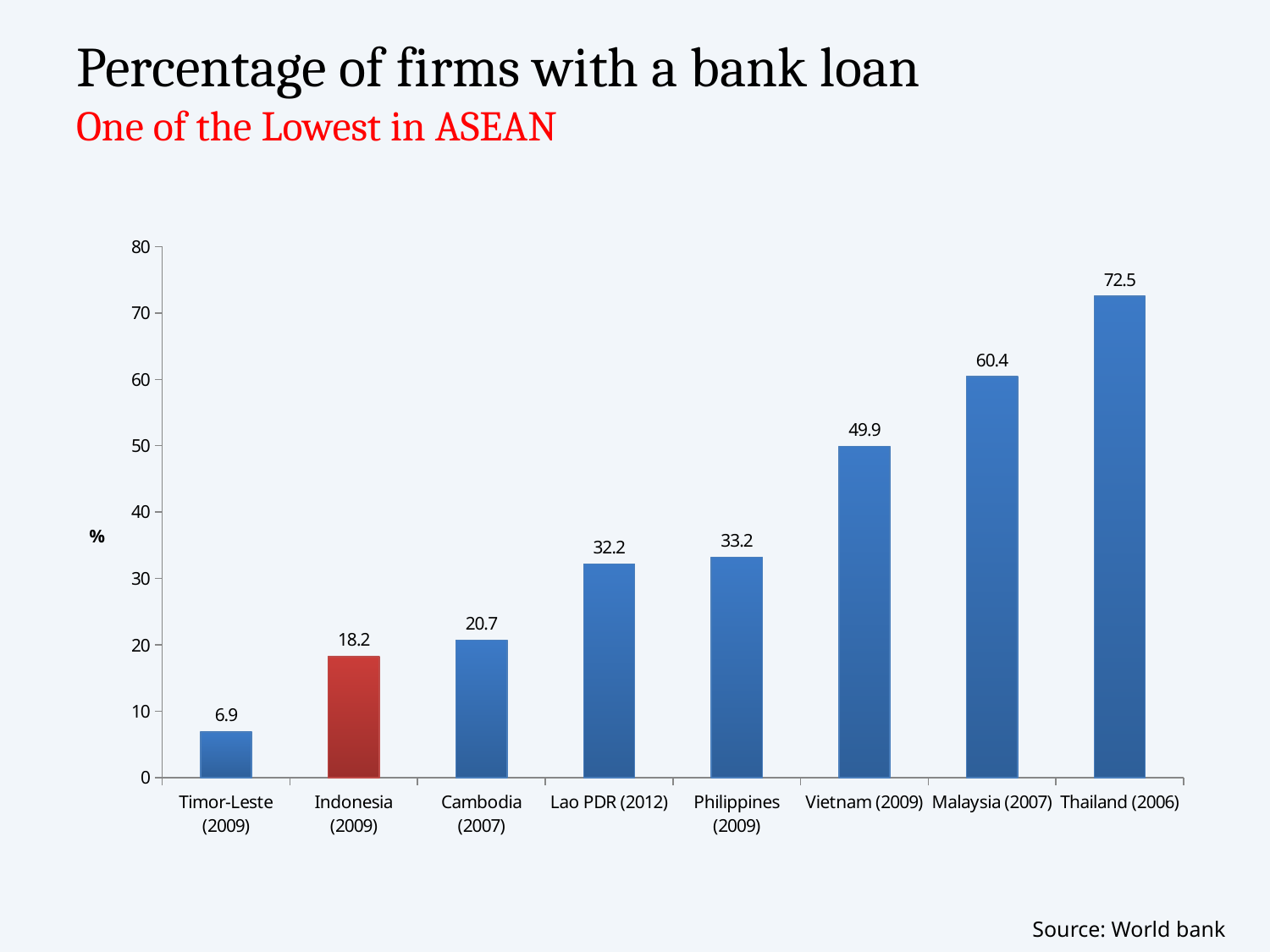
Which bar is highlighted in red? Indonesia (2009) Which has a higher value, Lao PDR (2012) or Cambodia (2007)? Lao PDR (2012) What is the percentage of firms with a bank loan for Indonesia (2009)? 18.2 Which country has the lowest percentage of firms with a bank loan? Timor-Leste (2009) What kind of chart is shown on the slide? Bar chart What is the difference between the values for Thailand (2006) and Indonesia (2009)? 54.3 What is the difference between the values for Malaysia (2007) and Vietnam (2009)? 10.5 How many countries are shown in the chart? 8 Which country has the highest percentage of firms with a bank loan? Thailand (2006) What is the value shown for Cambodia (2007)? 20.7 What is the value shown for Vietnam (2009)? 49.9 Is the value for Malaysia (2007) greater or less than 50? greater